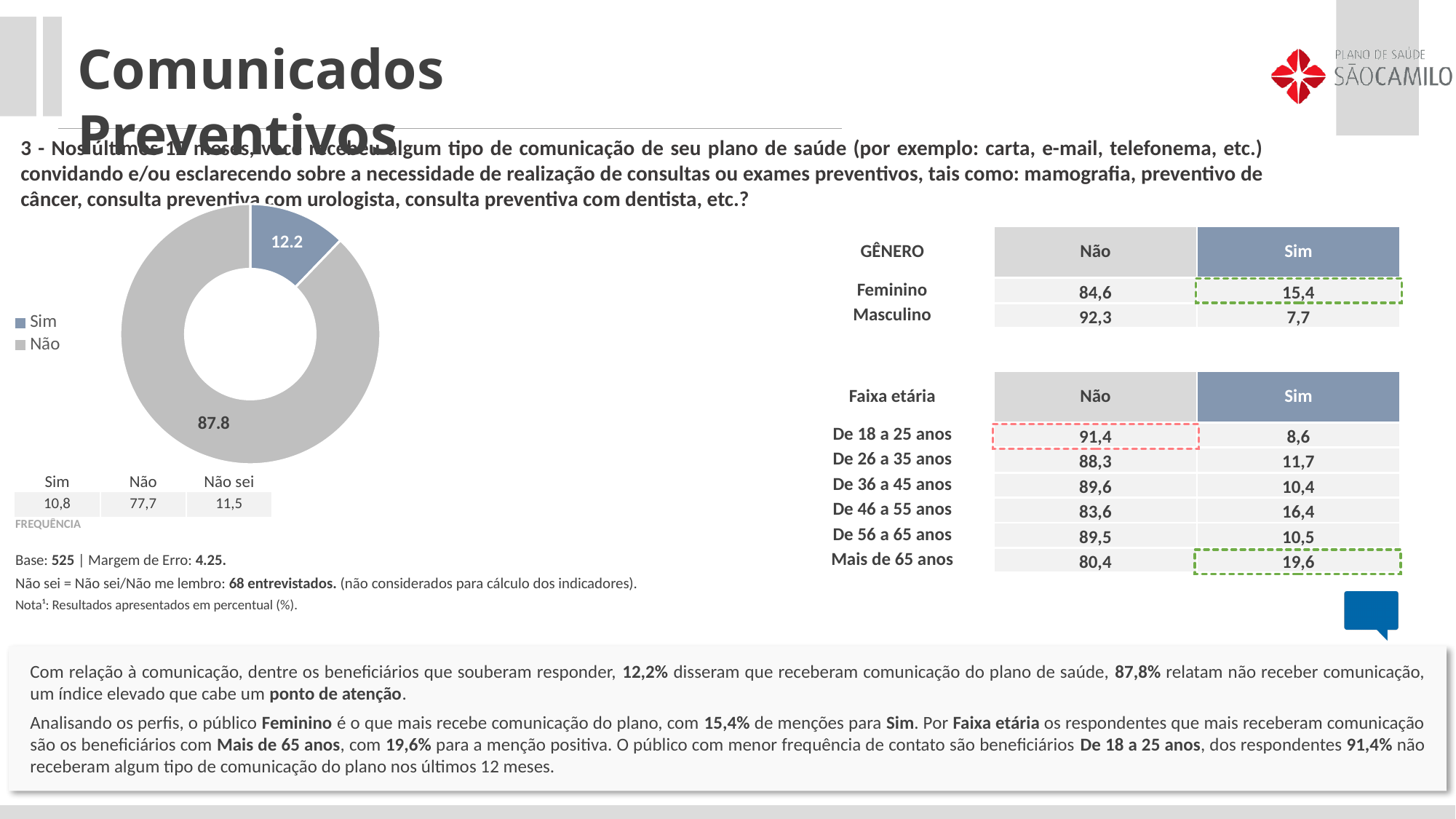
In the donut chart, what value is shown for "Sim"? 12.2 How many entries does the legend of the donut chart list? 2 What colour is the "Sim" slice in the donut chart? blue What colour is the "Não" slice in the donut chart? grey Which slice of the donut chart is the largest? Não Which slice of the donut chart is the smallest? Sim In the donut chart, which is larger: "Sim" or "Não"? Não In the donut chart, what is the difference between the "Não" value and the "Sim" value? 75.6 What share of the donut chart does the "Sim" slice represent? 12.2 How many slices does the donut chart have? 2 In the donut chart, what value is shown for "Não"? 87.8 What kind of chart is shown on the left of the slide? pie chart (donut)